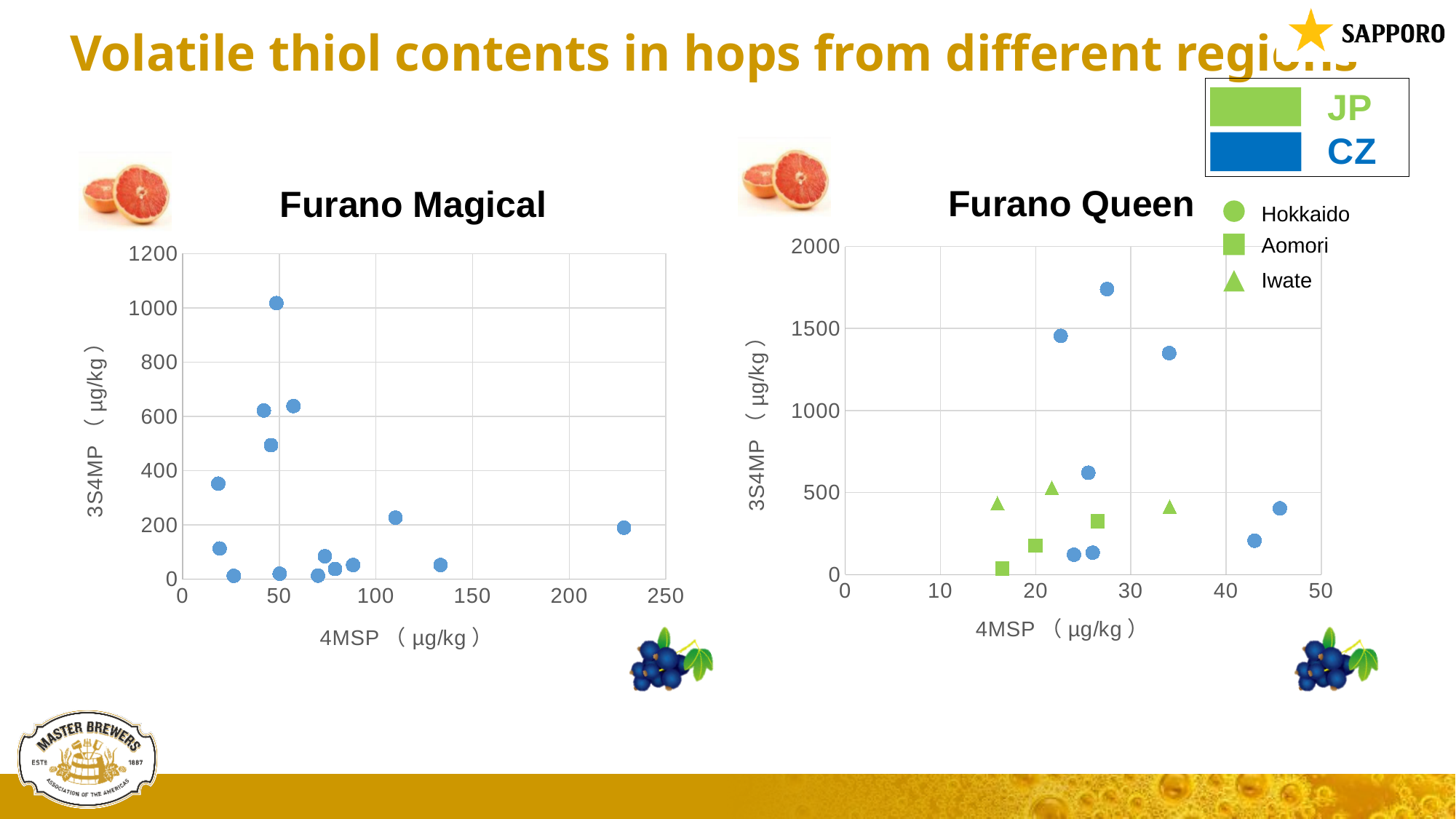
In the Furano Magical chart, is the 4MSP value of the rightmost point greater or less than 200? greater In the Furano Queen chart, which marker shape represents Hokkaido? circle Which chart has a point with a higher 3S4MP value, Furano Magical or Furano Queen? Furano Queen In the Furano Magical chart, what is the highest value shown on the 3S4MP (y) axis? 1200 In the Furano Queen chart, is the 3S4MP value of the highest point greater or less than 1500? greater In the Furano Queen chart, how many green square (Aomori) points are plotted? 3 In the Furano Queen chart, is the 3S4MP value of the rightmost point greater or less than 500? less What kind of chart is the Furano Queen chart? scatter chart In the Furano Queen chart, what is the highest value shown on the 4MSP (x) axis? 50 What kind of chart is the Furano Magical chart? scatter chart In the Furano Queen chart, how many green triangle (Iwate) points are plotted? 3